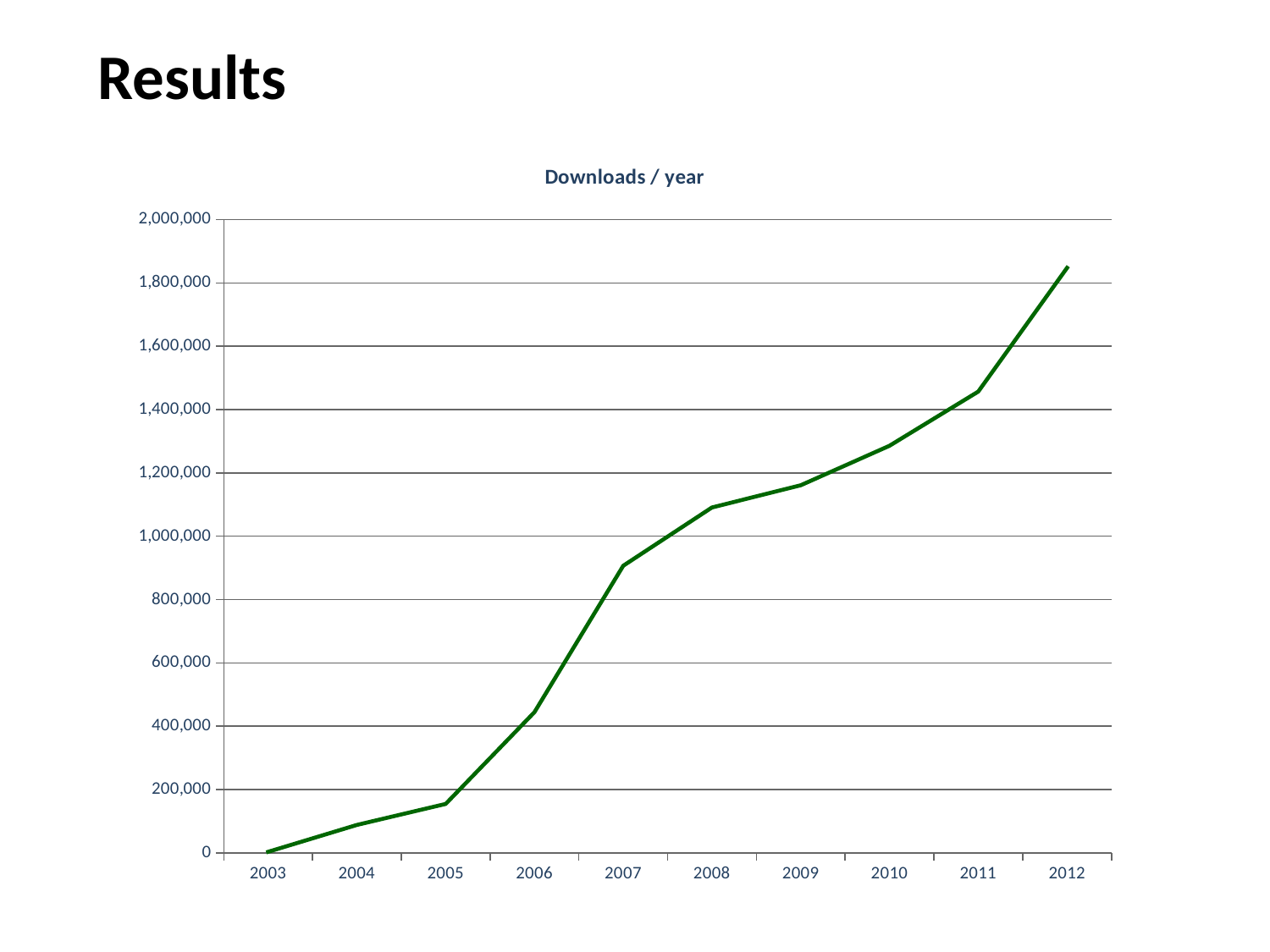
Which year has the lowest number of downloads? 2003 Is the value for 2004 greater or less than 200,000? less Is the value for 2012 greater or less than 1,600,000? greater Is the value for 2010 greater or less than 1,200,000? greater Which year has more downloads, 2006 or 2008? 2008 How many years are plotted on the x axis of the chart? 10 What is the title of the chart? Downloads / year What kind of chart is shown on the slide? line chart Which year has the highest number of downloads? 2012 Do the downloads per year rise or fall from 2003 to 2012? rise